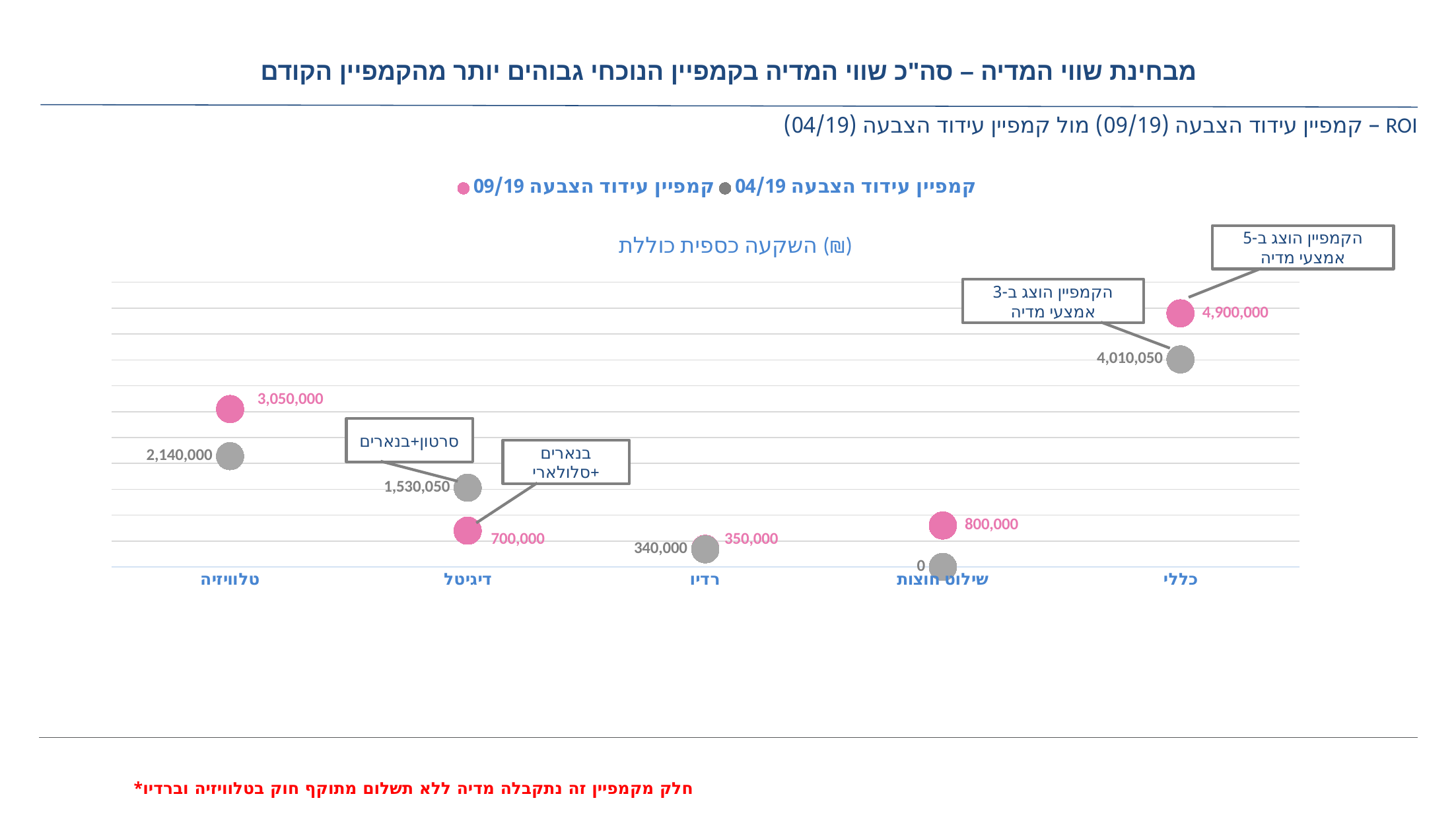
What is the value for כללי in the 09/19 series? 4,900,000 What is the difference between the 09/19 and 04/19 values for כללי? 889,950 Which category has the highest value in the 04/19 series? כללי What is the difference between the 09/19 and 04/19 values for טלוויזיה? 910,000 What is the value for דיגיטל in the 04/19 series (קמפיין עידוד הצבעה 04/19)? 1,530,050 For דיגיטל, which series has the larger value, 09/19 or 04/19? 04/19 What is the value for שילוט חוצות in the 04/19 series? 0 What is the value for טלוויזיה in the 09/19 series (קמפיין עידוד הצבעה 09/19)? 3,050,000 Which category has the lowest value in the 09/19 series? רדיו How many categories are shown on the x axis? 5 How many series does the legend list? 2 What is the title of the chart? השקעה כספית כוללת (₪)